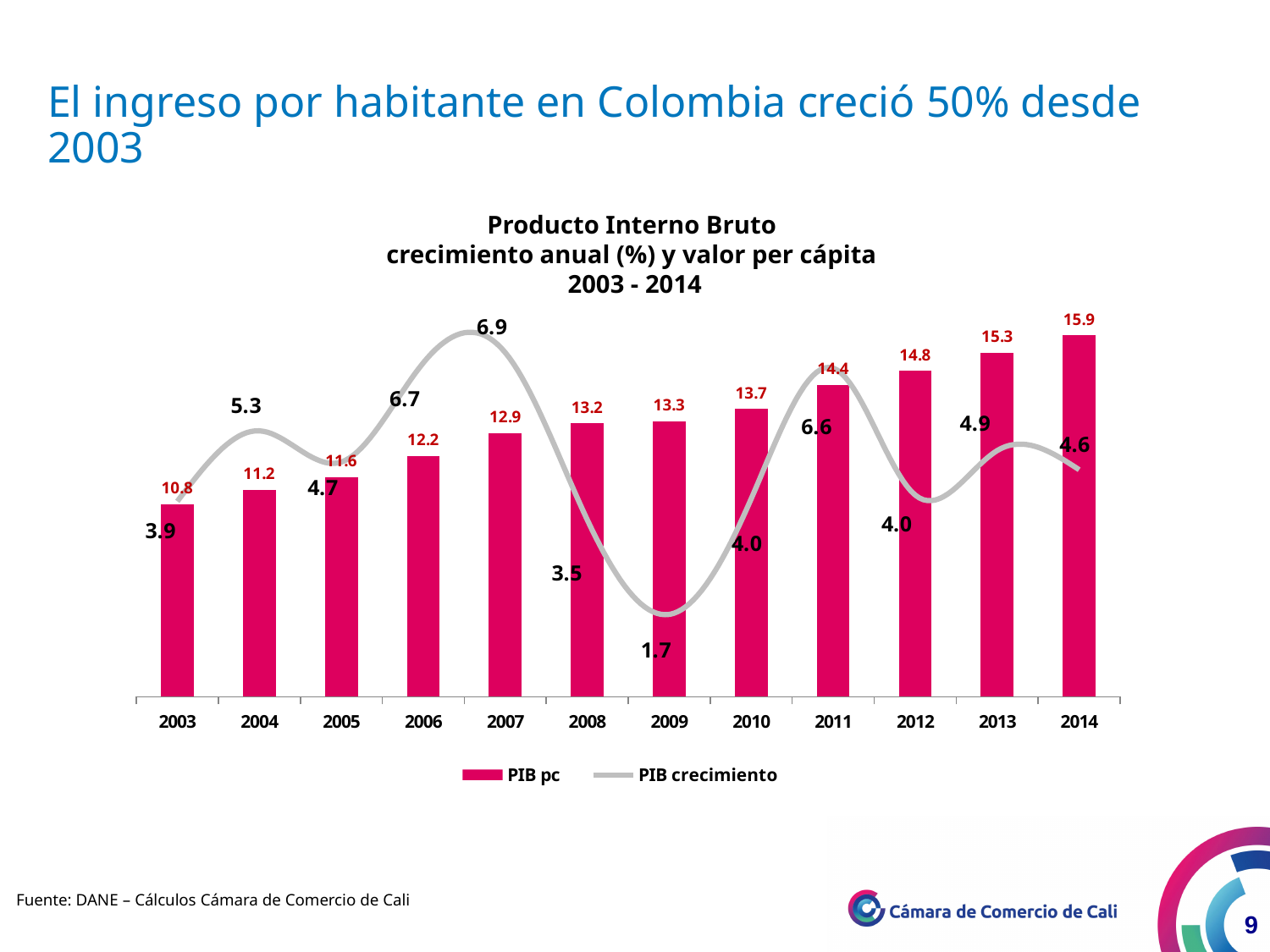
What kind of chart is used for the PIB pc series? Bar chart How many series does the legend list? 2 How many years are shown on the x axis? 12 What is the PIB pc value for 2014? 15.9 Which year has the highest PIB crecimiento value? 2007 What is the PIB pc value for 2008? 13.2 What is the PIB crecimiento value for 2009? 1.7 Which year has the lowest PIB pc value? 2003 What is the difference between the PIB pc values for 2014 and 2003? 5.1 What are the two series named in the legend? PIB pc and PIB crecimiento Which is larger, the PIB crecimiento value for 2011 or for 2012? 2011 Do the PIB pc values rise or fall from 2003 to 2014? Rise